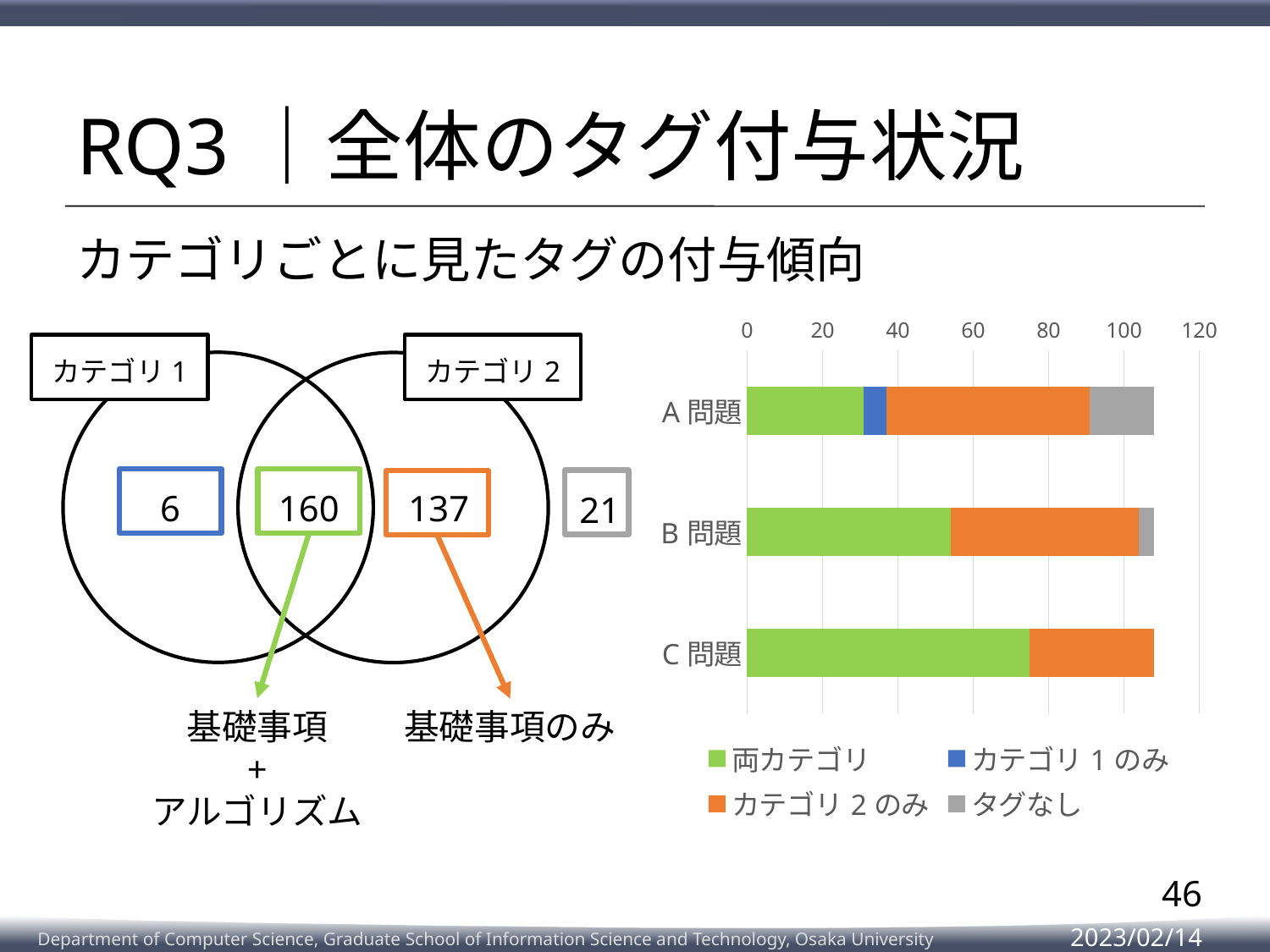
Is the 両カテゴリ value for B 問題 greater or less than 40? greater What is the highest value shown on the x axis of the bar chart? 120 What colour represents タグなし in the bar chart legend? gray Is the 両カテゴリ value for A 問題 greater or less than 40? less How many series does the legend of the bar chart list? 4 Which category has the shortest 両カテゴリ (green) segment? A 問題 Which is larger, the 両カテゴリ segment for C 問題 or for A 問題? C 問題 Is the 両カテゴリ value for C 問題 greater or less than 60? greater Which category is the only one with a カテゴリ 1 のみ (blue) segment? A 問題 What kind of chart is shown on the right of the slide? stacked bar chart Which category has the longest 両カテゴリ (green) segment? C 問題 How many categories (問題) are plotted on the bar chart? 3